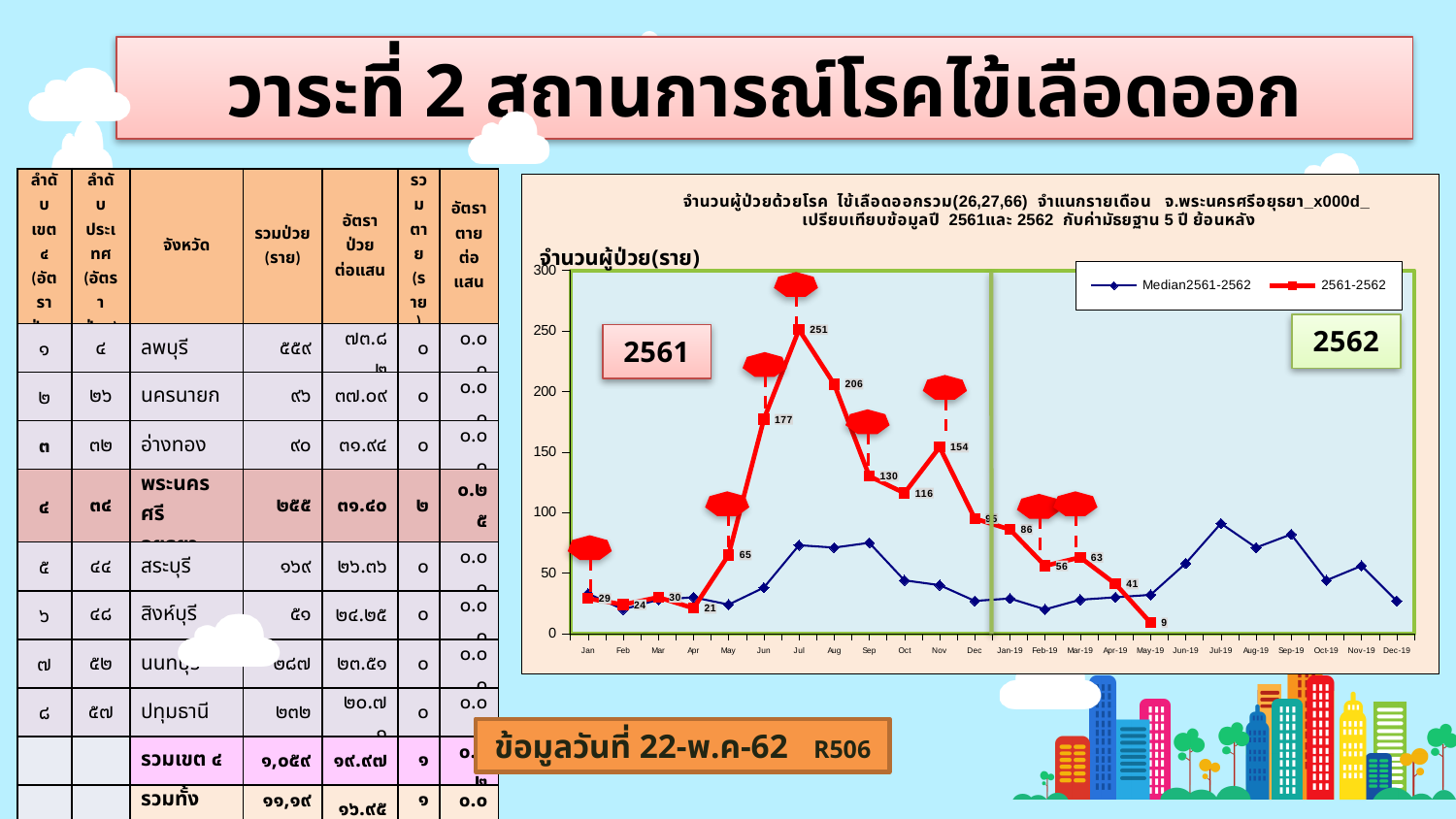
In the line chart, does the 2561-2562 series rise or fall from Jan-19 to May-19? fall In the line chart, what is the value of the 2561-2562 series for Jun? 177 How many series does the legend of the line chart list? 2 In the line chart, what is the difference between the 2561-2562 values for Jul and Aug? 45 In the line chart, which month has the highest value for the 2561-2562 series? Jul In the line chart, is the Median2561-2562 value for Jul-19 greater or less than 100? less In the line chart, what is the value of the 2561-2562 series for Nov? 154 In the line chart, which month has the lowest value for the 2561-2562 series? May-19 What type of chart is shown on the right side of the slide? line chart In the line chart, what is the value of the 2561-2562 series for Jul? 251 In the line chart, which is larger for the 2561-2562 series: Sep or Oct? Sep In the line chart, what is the value of the 2561-2562 series for May-19? 9